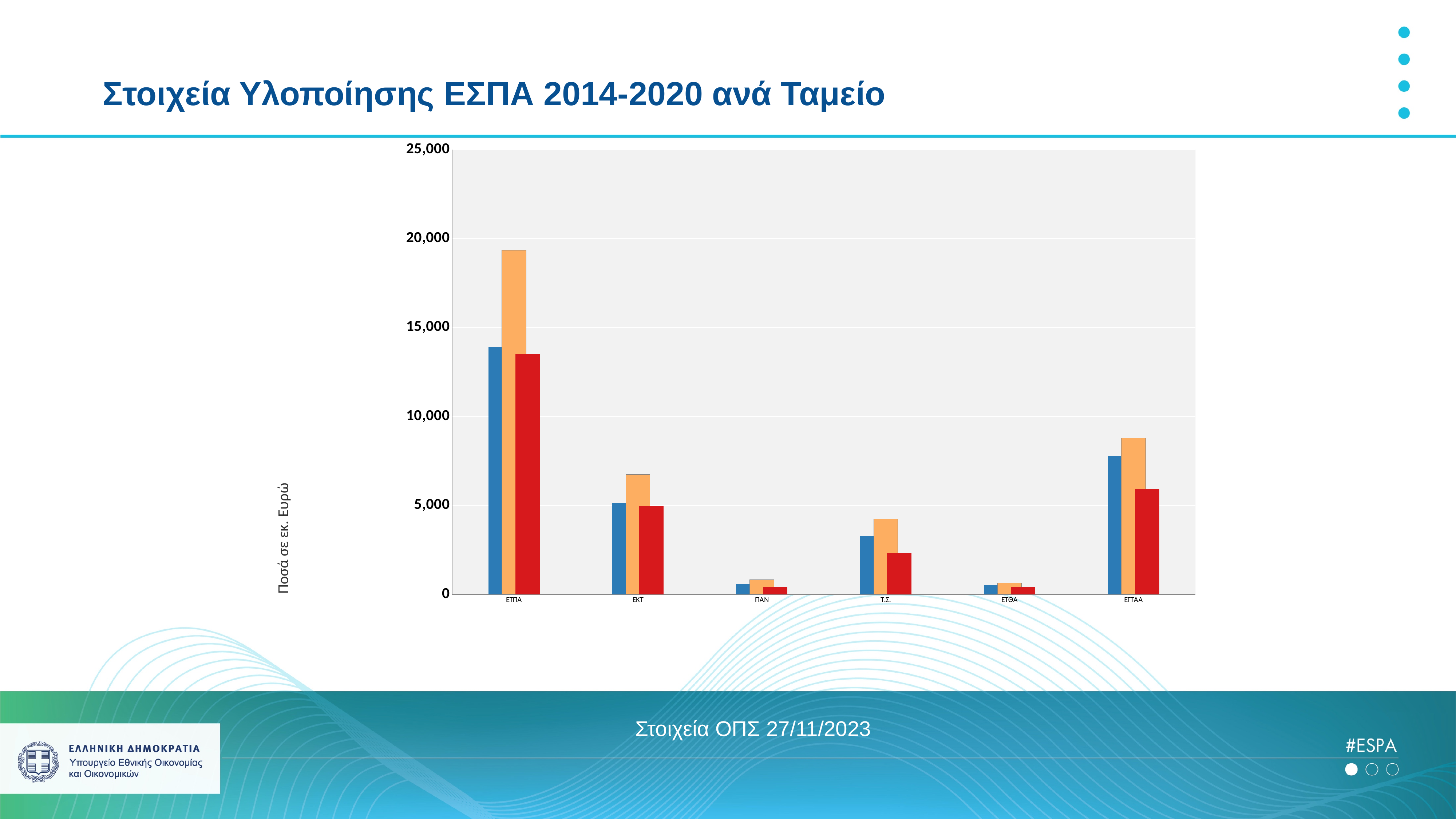
How many bars are plotted for each category in the chart? 3 Which is larger: the orange bar for ΕΚΤ or the orange bar for ΕΓΤΑΑ? ΕΓΤΑΑ Is the value of the orange bar for Τ.Σ. greater or less than 5,000? less What kind of chart is shown on the slide? Bar chart What is the title of the vertical axis of the chart? Ποσά σε εκ. Ευρώ Is the value of the blue bar for ΕΓΤΑΑ greater or less than 5,000? greater Is the value of the orange bar for ΕΤΠΑ greater or less than 15,000? greater How many categories are shown on the x axis of the chart? 6 Which is larger for ΕΤΠΑ: the blue bar or the orange bar? The orange bar Which category has the tallest bars in the chart? ΕΤΠΑ